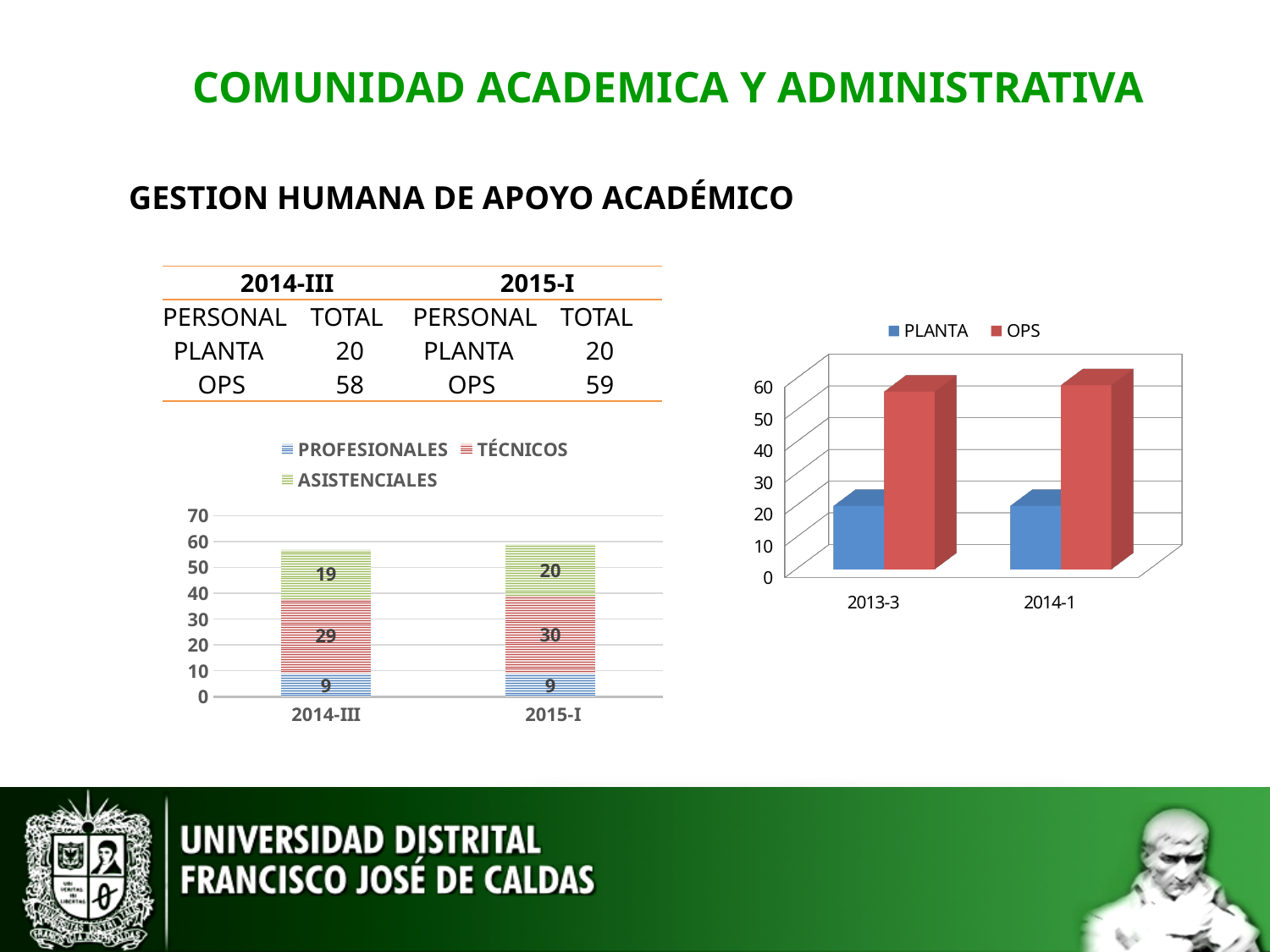
In the stacked bar chart on the left, what is the total of the 2015-I bar? 59 In the stacked bar chart on the left, what is the difference between TÉCNICOS in 2015-I and TÉCNICOS in 2014-III? 1 In the stacked bar chart on the left, what is the value for ASISTENCIALES in 2014-III? 19 In the stacked bar chart on the left, what is the total of the 2014-III bar? 57 In the chart on the right, is the value for OPS in 2014-1 greater or less than 50? greater In the stacked bar chart on the left, how many series does the legend list? 3 In the stacked bar chart on the left, what is the value for PROFESIONALES in 2015-I? 9 In the stacked bar chart on the left, which series has the largest value in 2014-III? TÉCNICOS In the chart on the right, which series is larger in 2013-3, PLANTA or OPS? OPS In the chart on the right, is the value for PLANTA in 2013-3 greater or less than 30? less In the chart on the right, how many series does the legend list? 2 In the stacked bar chart on the left, what is the value for TÉCNICOS in 2015-I? 30